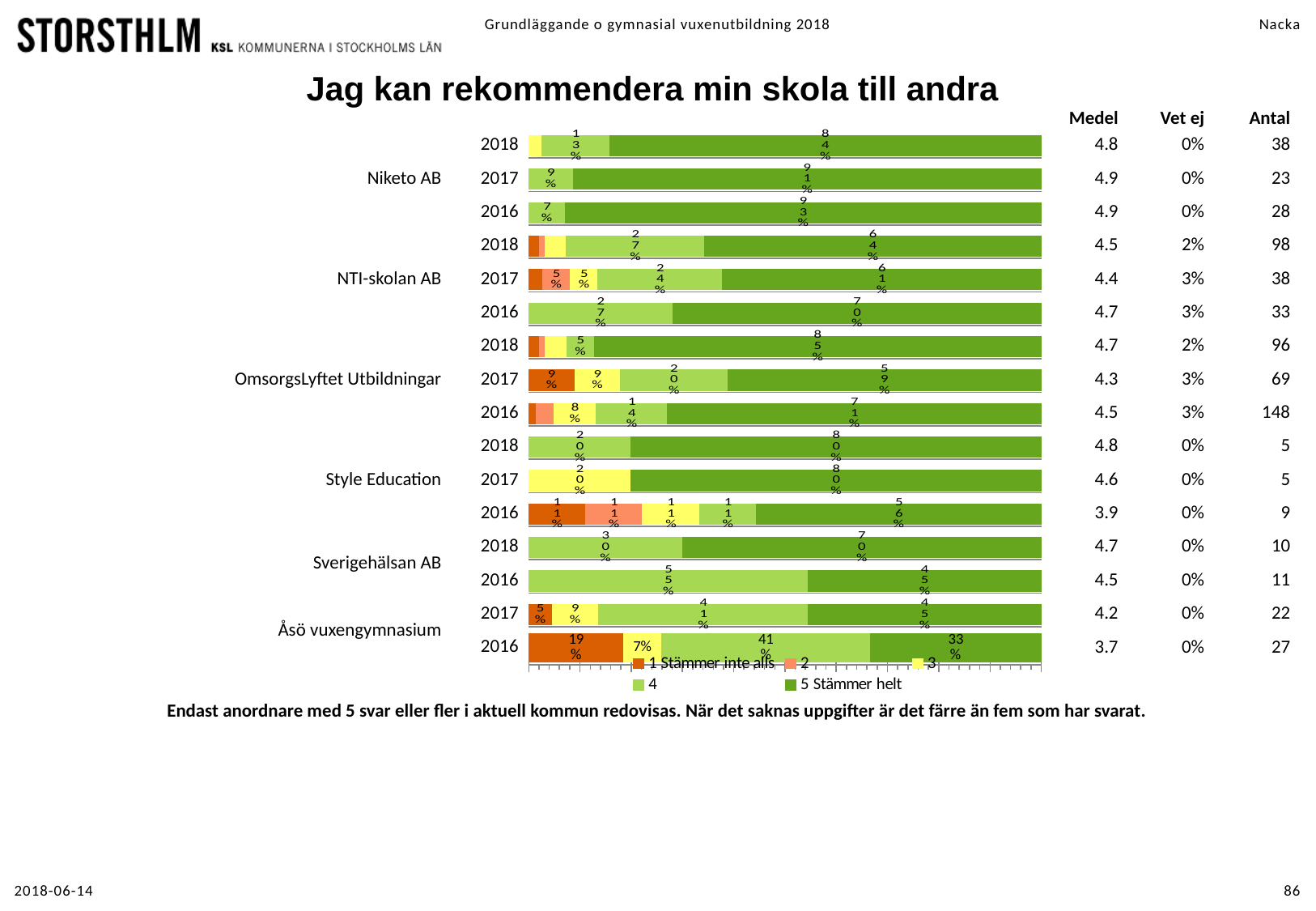
What kind of chart is shown on the slide? Stacked bar chart What percentage of Åsö vuxengymnasium respondents in 2017 answered "5 Stämmer helt"? 45% What percentage of OmsorgsLyftet Utbildningar respondents in 2017 answered "4"? 20% What is the combined share of answers 1 through 4 for Style Education in 2016? 44% What percentage of Åsö vuxengymnasium respondents in 2016 answered "1 Stämmer inte alls"? 19% Which has a larger "5 Stämmer helt" share in 2018: Niketo AB or NTI-skolan AB? Niketo AB What percentage of Sverigehälsan AB respondents in 2016 answered "4"? 55% What percentage of Niketo AB respondents in 2016 answered "5 Stämmer helt"? 93% In which year did Niketo AB have its highest "5 Stämmer helt" share? 2016 How many series does the legend list? 5 How many bars are plotted in the chart? 16 For Style Education in 2016, how many percentage points larger is the "5 Stämmer helt" share than the "1 Stämmer inte alls" share? 45 percentage points